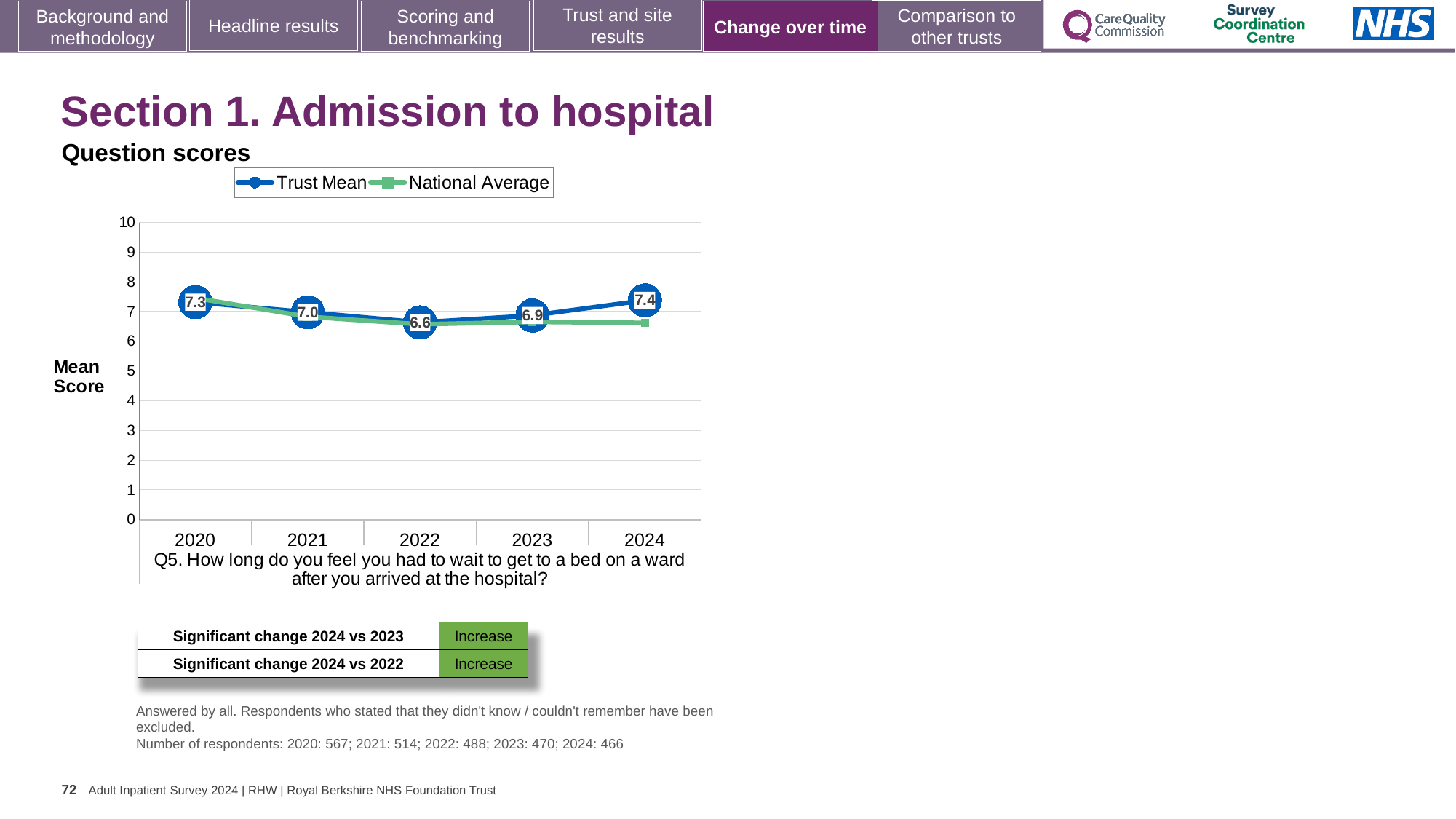
What is the Trust Mean value for 2022? 6.6 What is the Trust Mean value for 2024? 7.4 What is the Trust Mean value for 2020? 7.3 How many series does the legend list? 2 Does the Trust Mean rise or fall from 2022 to 2024? rise Is the National Average value for 2024 greater or less than 7? less Which year has the highest Trust Mean? 2024 Which is larger, the Trust Mean for 2021 or for 2023? 2021 Which year has the lowest Trust Mean? 2022 What is the difference between the Trust Mean in 2024 and in 2022? 0.8 How many years are plotted on the x axis? 5 What kind of chart is shown on the slide? line chart